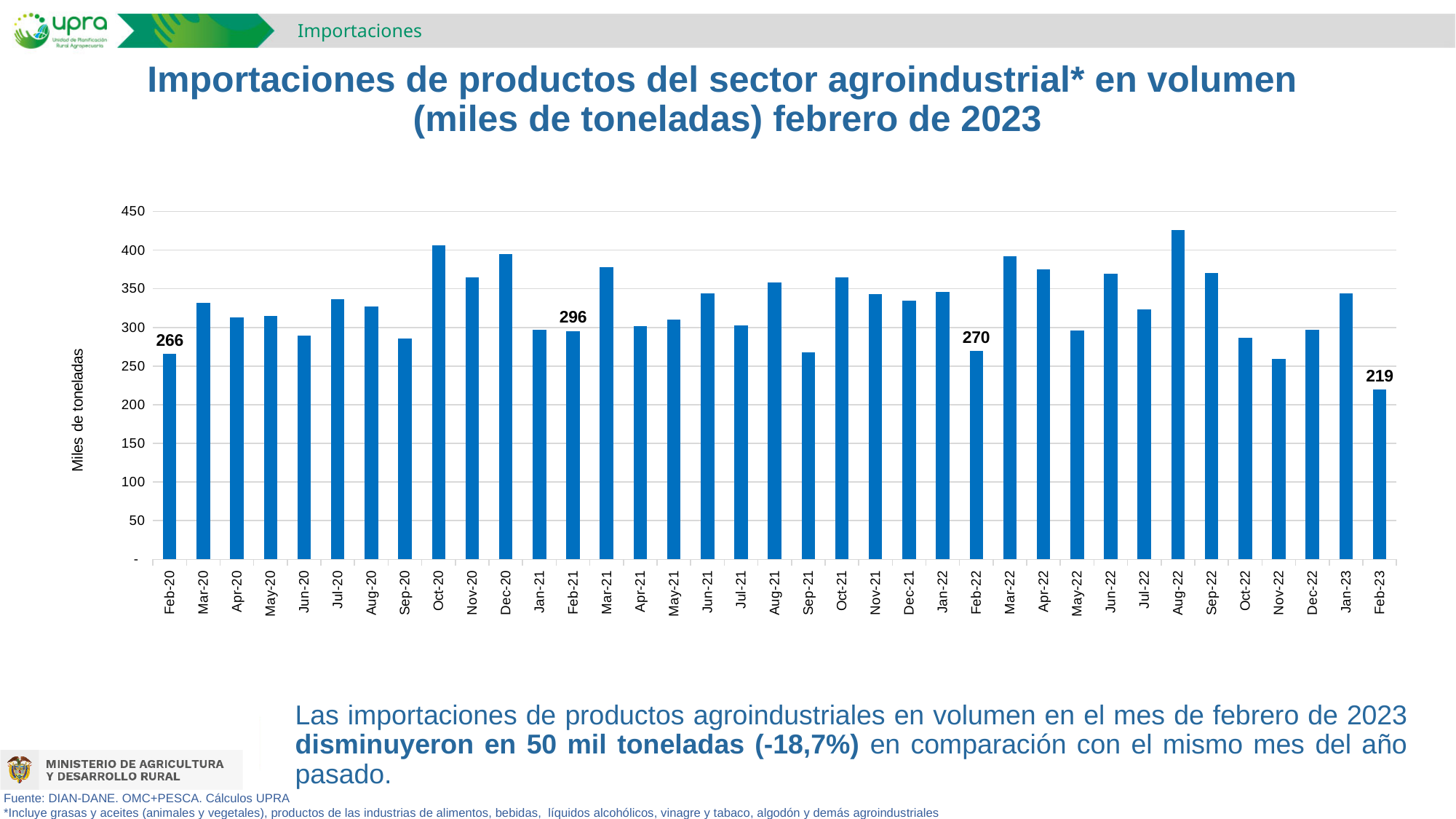
Which is larger, the value for Feb-21 or the value for Feb-22? Feb-21 What is the value for Feb-20? 266 What is the difference between the values for Feb-21 and Feb-20? 30 Is the value for Aug-22 greater or less than 400? greater What is the value for Feb-23? 219 What is the value for Feb-22? 270 What kind of chart is shown on the slide? bar chart Which month has the highest bar? Aug-22 Is the value for Nov-22 greater or less than 300? less Which month has the lowest bar? Feb-23 What is the value for Feb-21? 296 How many months are plotted on the chart? 37